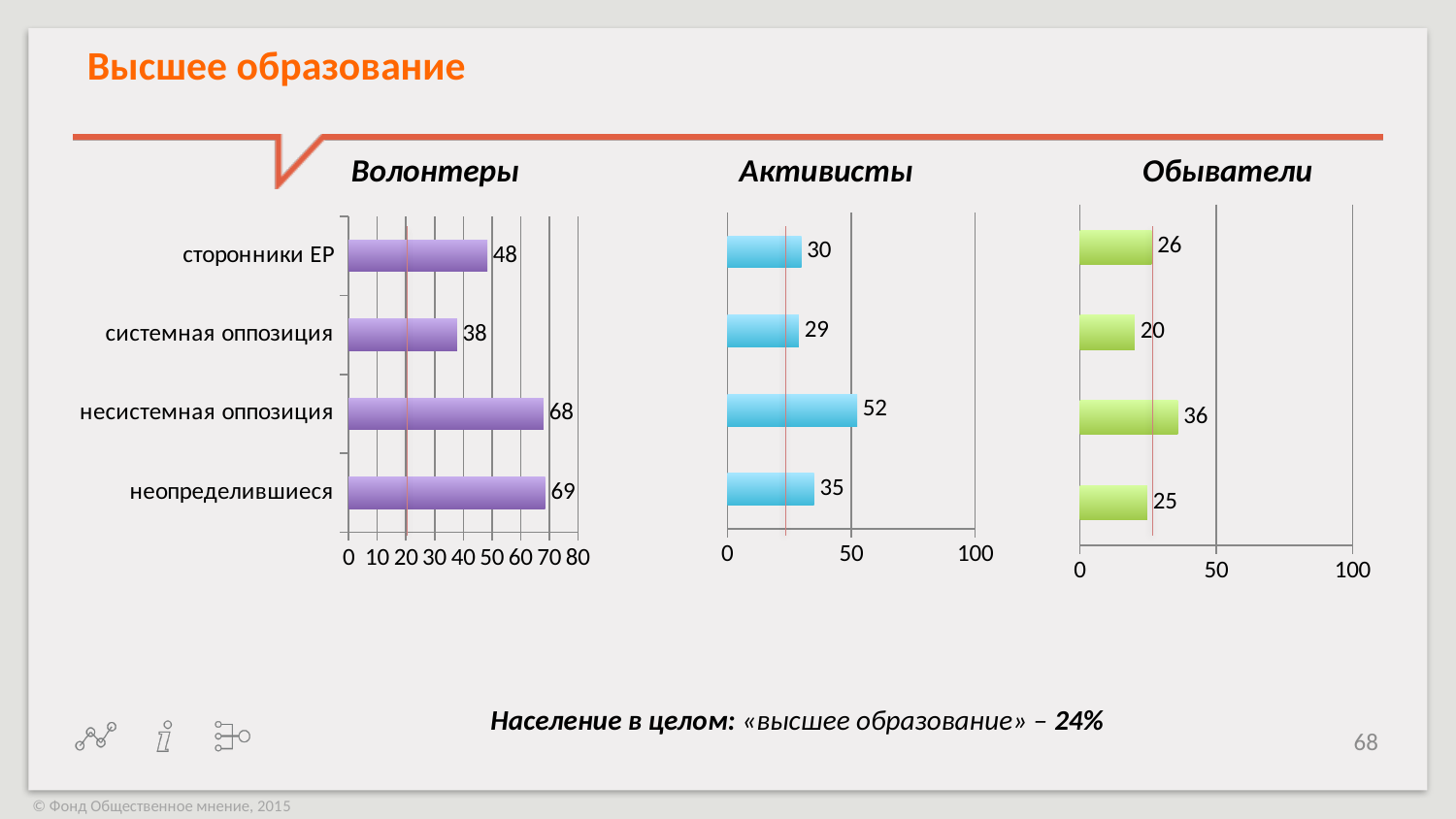
In the Обыватели chart, what is the value for системная оппозиция? 20 In the Активисты chart, what is the value for несистемная оппозиция? 52 In the Волонтеры chart, what is the value for сторонники ЕР? 48 In the Активисты chart, which category has the highest value? несистемная оппозиция In the Активисты chart, what is the difference between the values for неопределившиеся and сторонники ЕР? 5 In the Обыватели chart, which is larger: the value for сторонники ЕР or the value for неопределившиеся? сторонники ЕР In the Волонтеры chart, what is the difference between the values for несистемная оппозиция and системная оппозиция? 30 How many categories are shown in the Волонтеры chart? 4 What is the title of the slide? Высшее образование In the Обыватели chart, which category has the highest value? несистемная оппозиция What type of chart is the Активисты chart? bar chart In the Волонтеры chart, which category has the lowest value? системная оппозиция